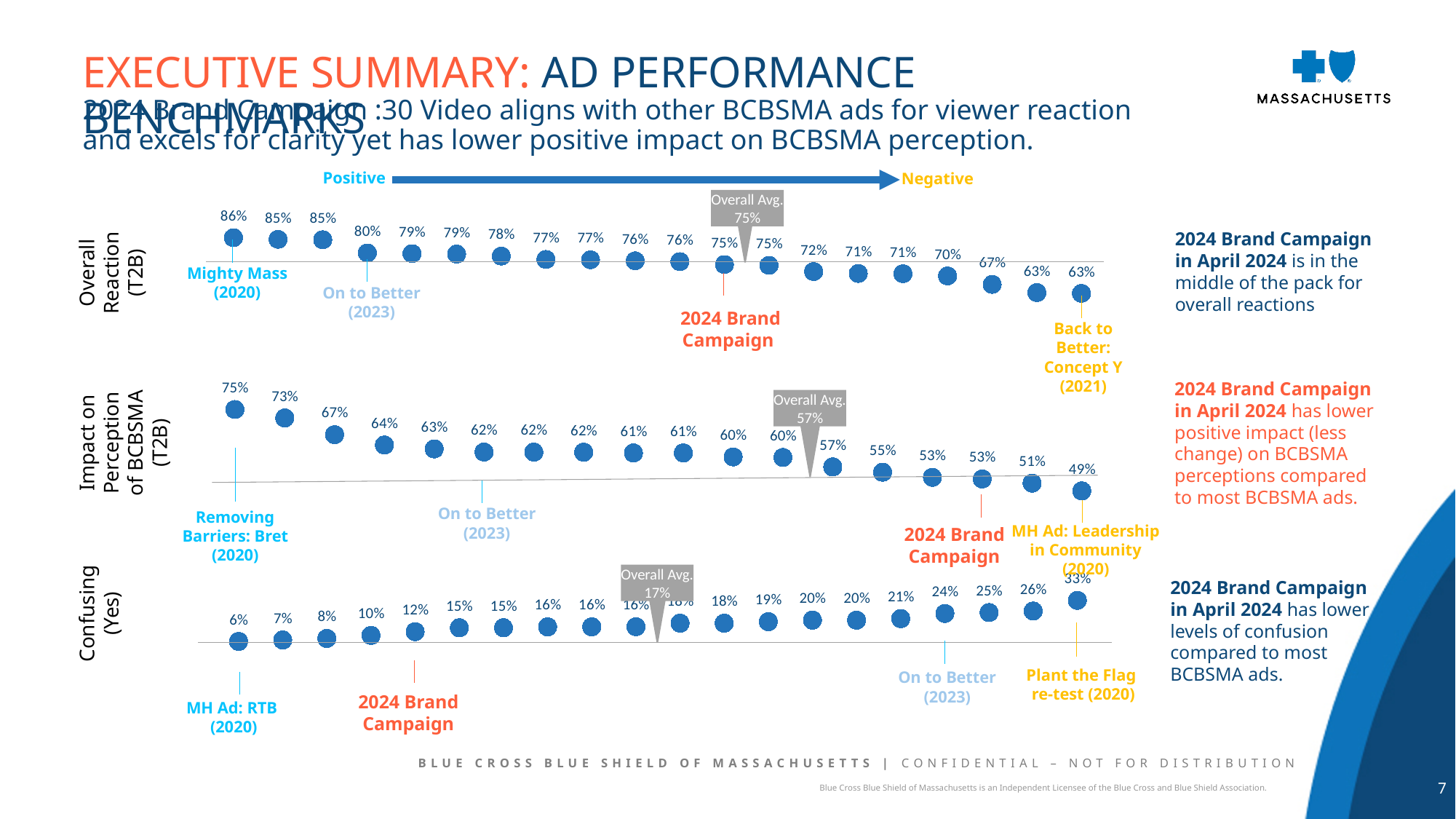
On the Overall Reaction (T2B) chart, what is the difference between Mighty Mass (2020) and Back to Better: Concept Y (2021)? 23 percentage points On the Confusing (Yes) chart, what is the value for the 2024 Brand Campaign? 12% On the Impact on Perception of BCBSMA (T2B) chart, what is the value for the 2024 Brand Campaign? 53% On the Impact on Perception of BCBSMA (T2B) chart, what is the value for Removing Barriers: Bret (2020)? 75% On the Confusing (Yes) chart, what is the value for MH Ad: RTB (2020)? 6% On the Confusing (Yes) chart, which labelled ad has the highest value? Plant the Flag re-test (2020) On the Overall Reaction (T2B) chart, what is the value for Back to Better: Concept Y (2021)? 63% On the Overall Reaction (T2B) chart, what is the value for the 2024 Brand Campaign? 75% On the Impact on Perception of BCBSMA (T2B) chart, what is the Overall Avg. shown? 57% On the Overall Reaction (T2B) chart, what is the value for Mighty Mass (2020)? 86% On the Overall Reaction (T2B) chart, how many data points are plotted? 20 On the Overall Reaction (T2B) chart, do the values rise or fall from left to right? fall